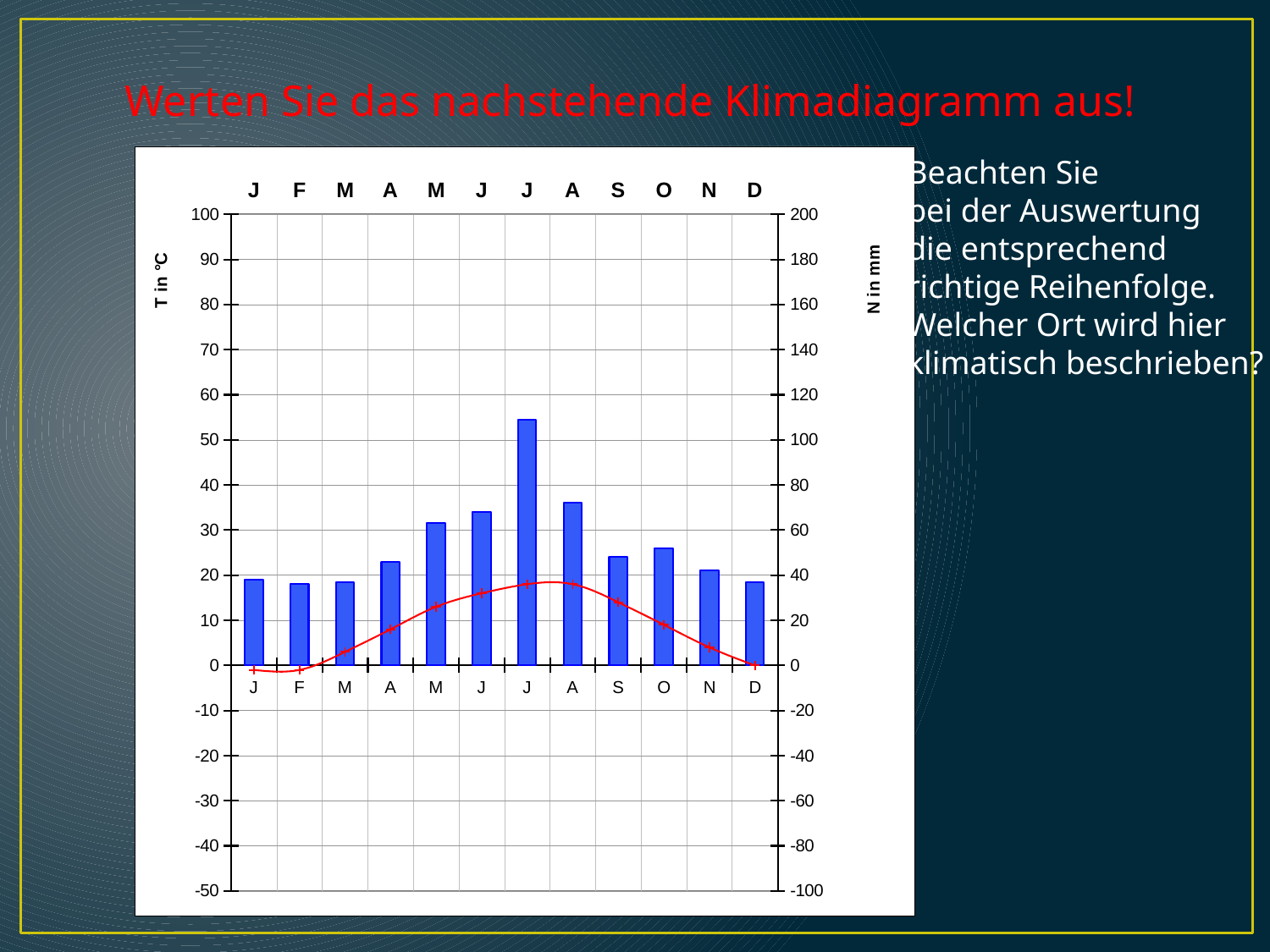
Is the precipitation bar for July (the seventh bar) greater or less than 100 mm? greater What kind of chart is shown on the slide? A combined bar and line chart (climate diagram) Is the temperature line value for July (the seventh month) greater or less than 10 °C? greater What is the label of the right-hand vertical axis? N in mm Is the precipitation bar for August (A) greater or less than 60 mm? greater Which month has the tallest precipitation bar? July (the seventh bar, J) Does the temperature line rise or fall from August to December? fall How many months (bars) are plotted along the x axis? 12 Which has the taller precipitation bar, July (the seventh bar) or August (A)? July Do the precipitation bars rise or fall from January to July? rise